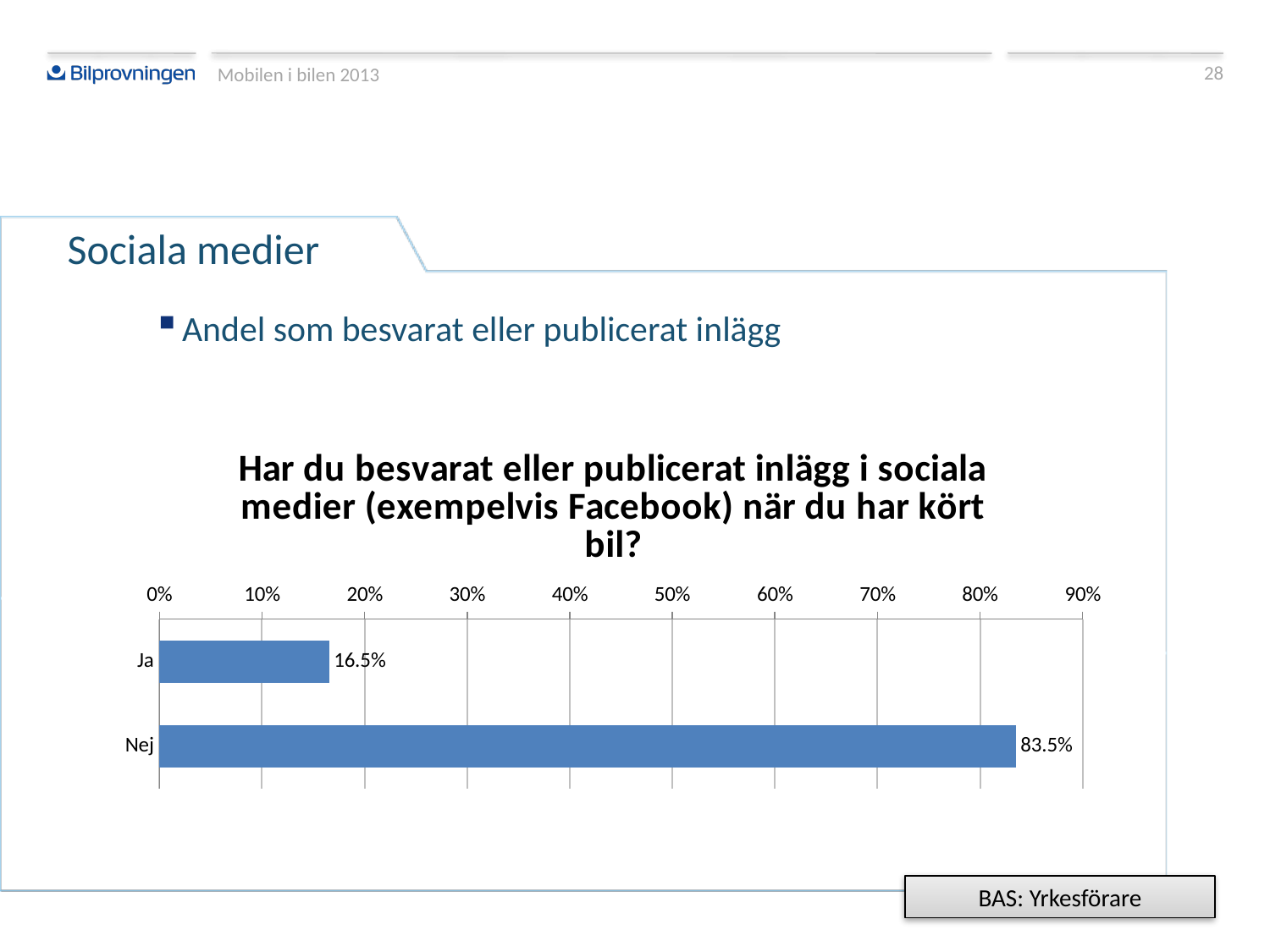
What is the value for Nej? 83.5% Is the value for Nej greater or less than 80%? greater Which category has the lowest value? Ja What is the difference between the values for Nej and Ja? 67.0% Is the value for Ja greater or less than 20%? less Which category has the highest value? Nej What is the value for Ja? 16.5% What is the title of the chart? Har du besvarat eller publicerat inlägg i sociala medier (exempelvis Facebook) när du har kört bil? How many categories are shown in the chart? 2 Which is larger, the value for Ja or the value for Nej? Nej What kind of chart is shown on the slide? bar chart What is the highest value shown on the x axis? 90%